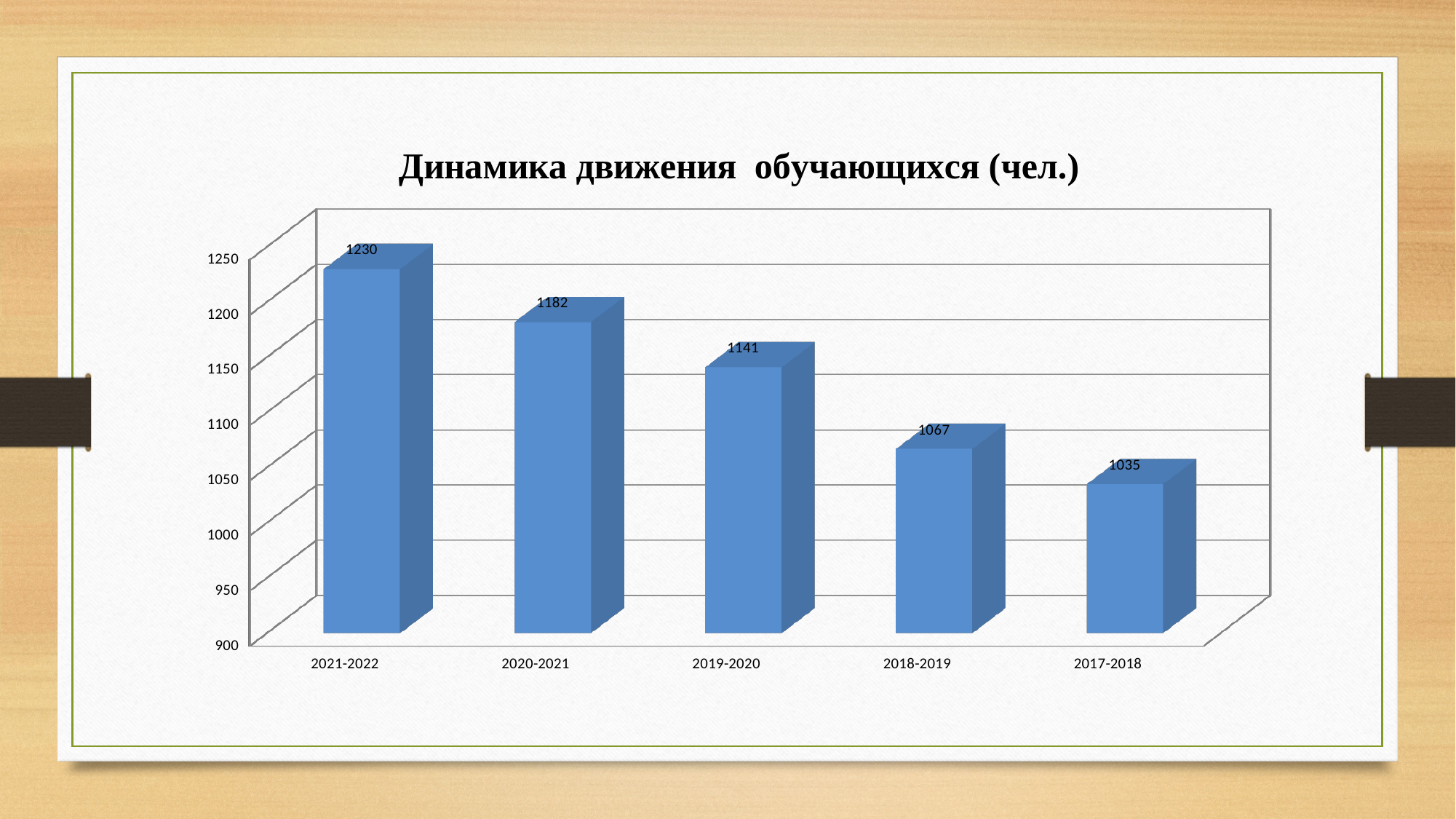
Is the value for 2019-2020 greater or less than 1100? greater What is the value for 2019-2020? 1141 What kind of chart is shown on the slide? bar chart What is the title of the chart? Динамика движения обучающихся (чел.) Which is larger, the value for 2020-2021 or the value for 2018-2019? 2020-2021 What is the value for 2017-2018? 1035 Which category has the highest value? 2021-2022 What is the difference between the values for 2018-2019 and 2017-2018? 32 What is the difference between the values for 2021-2022 and 2020-2021? 48 Which category has the lowest value? 2017-2018 What is the value for 2021-2022? 1230 How many categories are shown on the x axis? 5